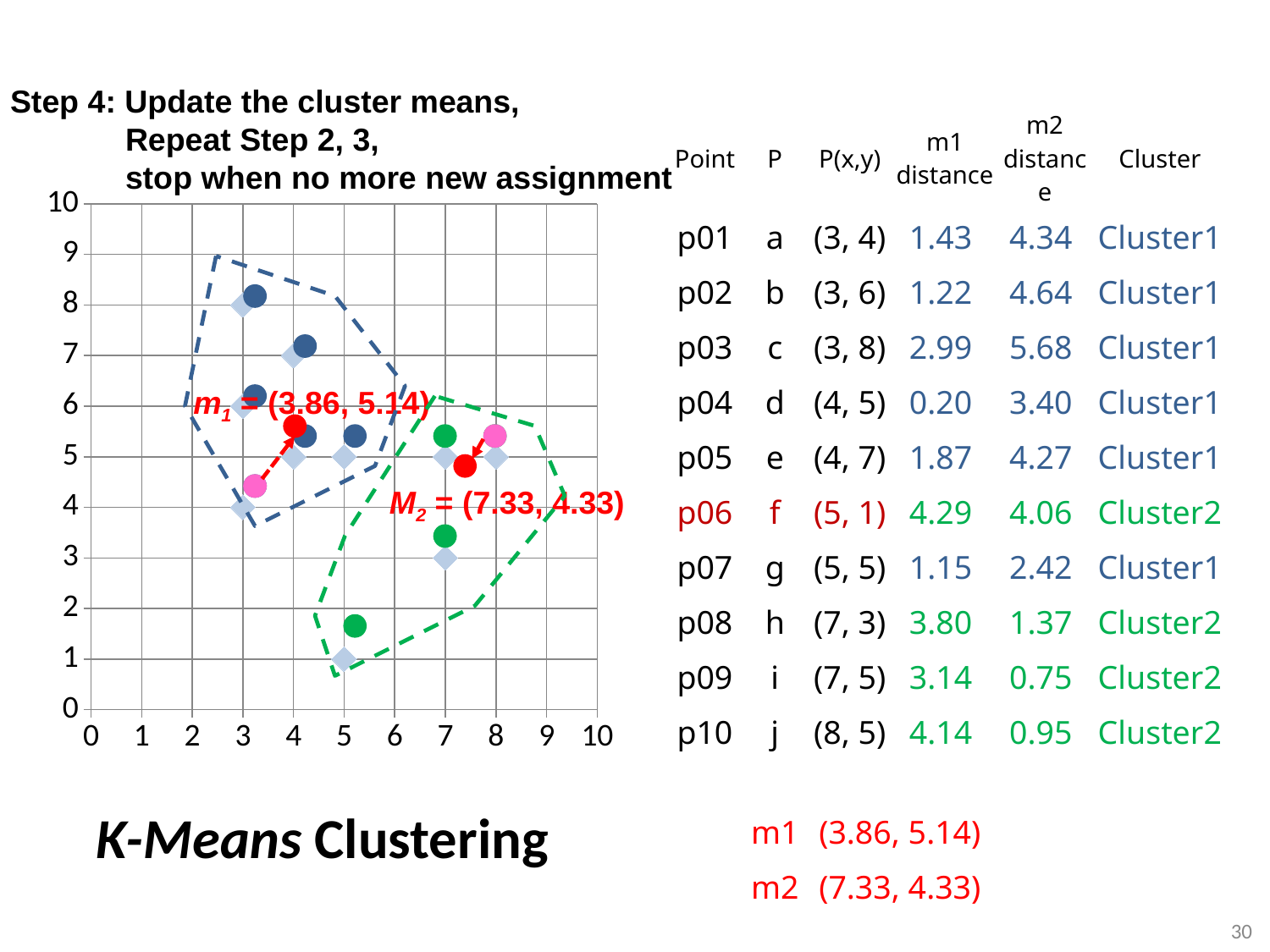
What are the coordinates of the cluster mean m1 as labelled on the chart? (3.86, 5.14) What are the coordinates of the point with the lowest y value on the chart? (5, 1) What is the difference between the x-coordinates of M2 and m1? 3.47 What colour are the markers for the cluster means m1 and M2 on the chart? red What is the difference between the y-coordinates of m1 and M2? 0.81 Is the x-coordinate of M2 greater or less than 7? greater Is the x-coordinate of m1 greater or less than 4? less What are the coordinates of the cluster mean M2 as labelled on the chart? (7.33, 4.33) What are the coordinates of the point with the highest y value on the chart? (3, 8) Which cluster mean has the larger x-coordinate, m1 or M2? M2 How many data points are enclosed by the green dashed boundary? 4 What kind of chart is shown on the slide? scatter chart